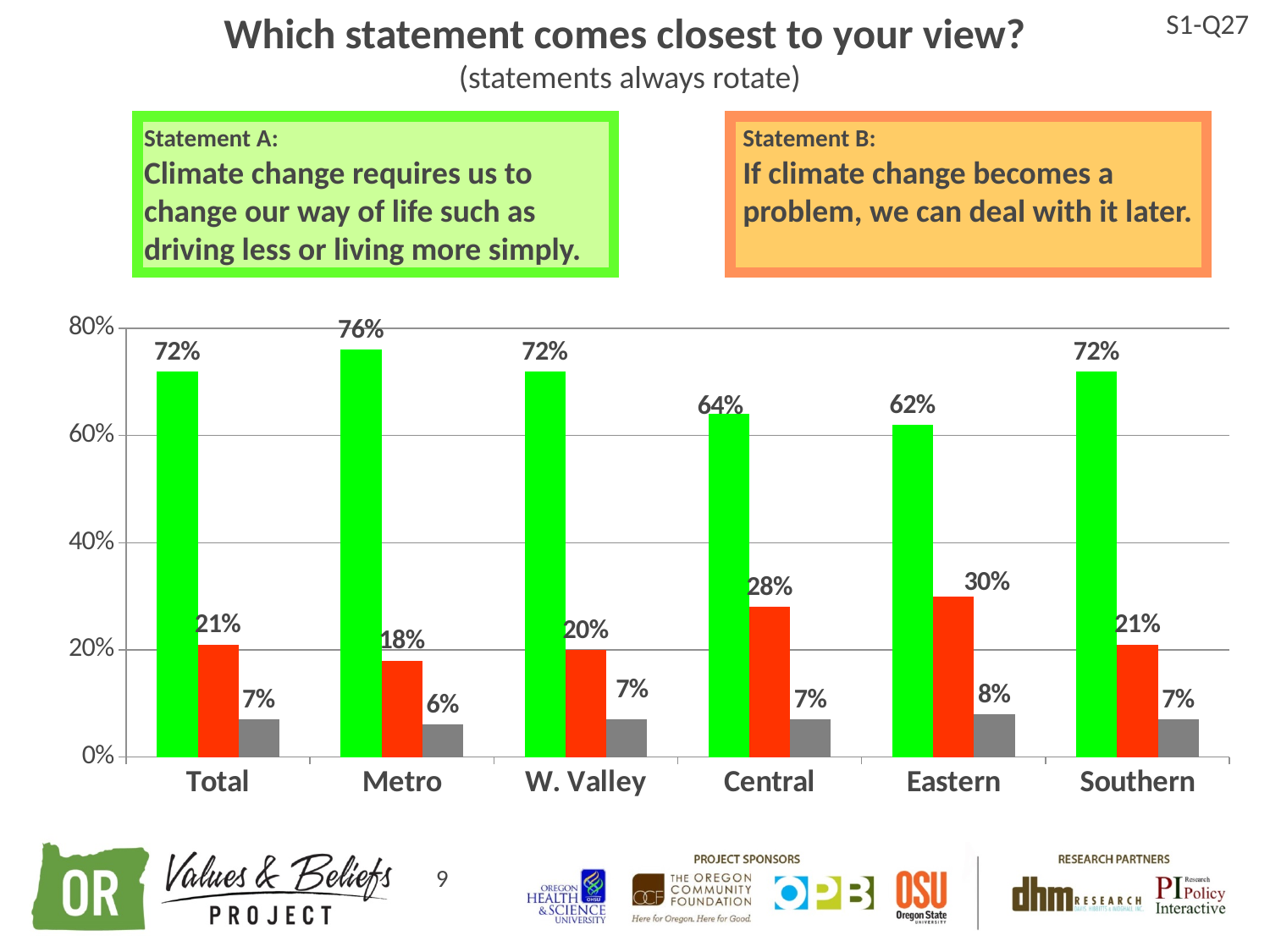
What is the value of the gray bar for Central? 7% How many categories are shown on the x axis? 6 Is the orange bar for Central larger or the orange bar for Metro? Central What is the value of the orange bar for Eastern? 30% Which category has the lowest green bar? Eastern Which category has the highest orange bar? Eastern Which category has the highest green bar? Metro What is the total of the three bars for Total? 100% What is the difference between the green bar for Metro and the green bar for Eastern? 14% What kind of chart is shown on the slide? Bar chart What is the value of the green bar for Metro? 76% What is the value of the green bar for Southern? 72%